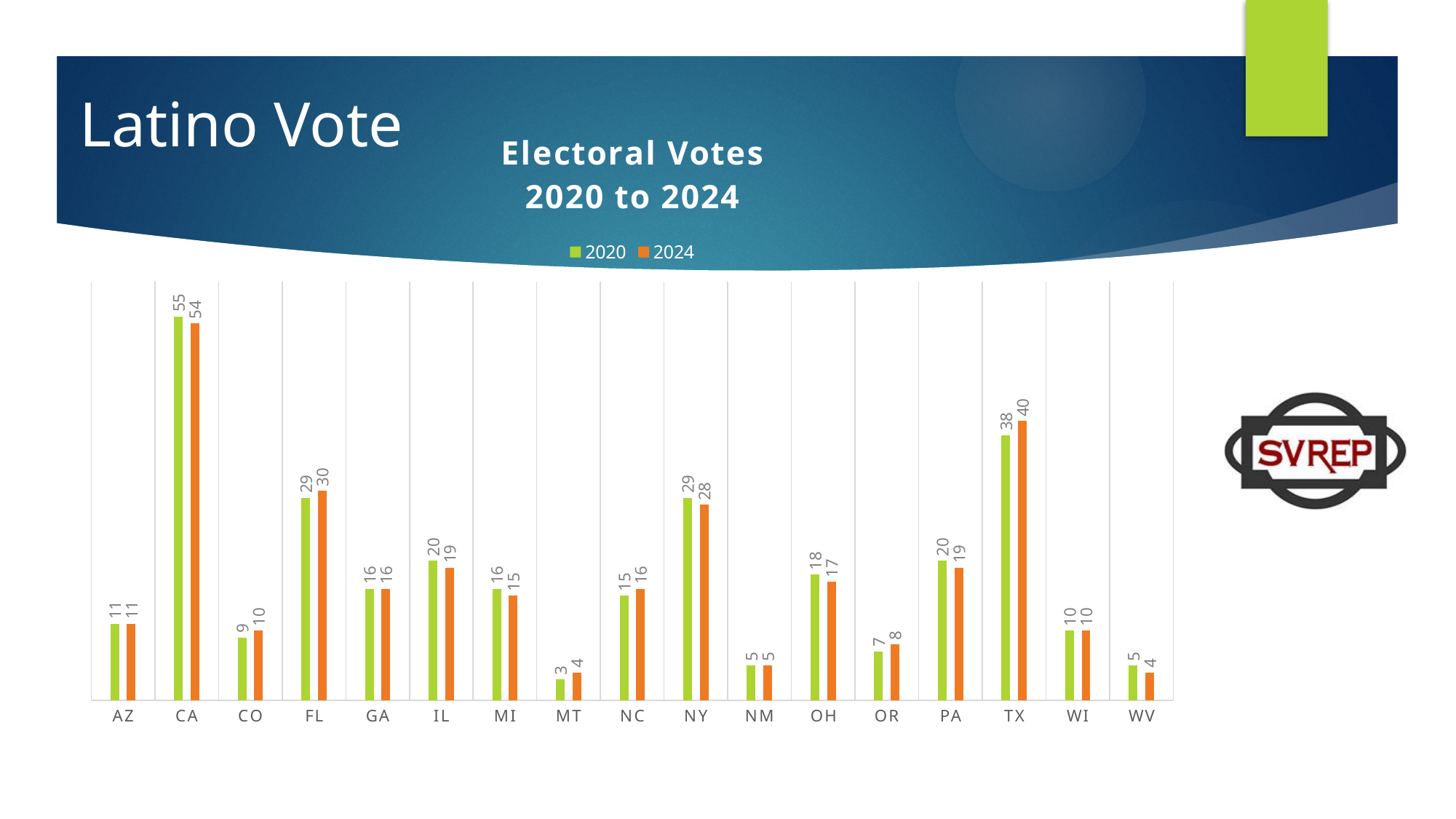
Which is larger, the 2024 value for OH or the 2024 value for PA? PA What is the 2020 value for FL? 29 What is the title of the chart? Electoral Votes 2020 to 2024 What is the difference between the 2024 values for CA and NY? 26 What is the 2024 value for TX? 40 Which state has the highest 2020 value? CA What is the 2024 value for MT? 4 What is the difference between the 2020 and 2024 values for TX? 2 How many states are shown on the x axis? 17 How many series does the legend list? 2 Which state has the lowest 2020 value? MT What kind of chart is shown? bar chart